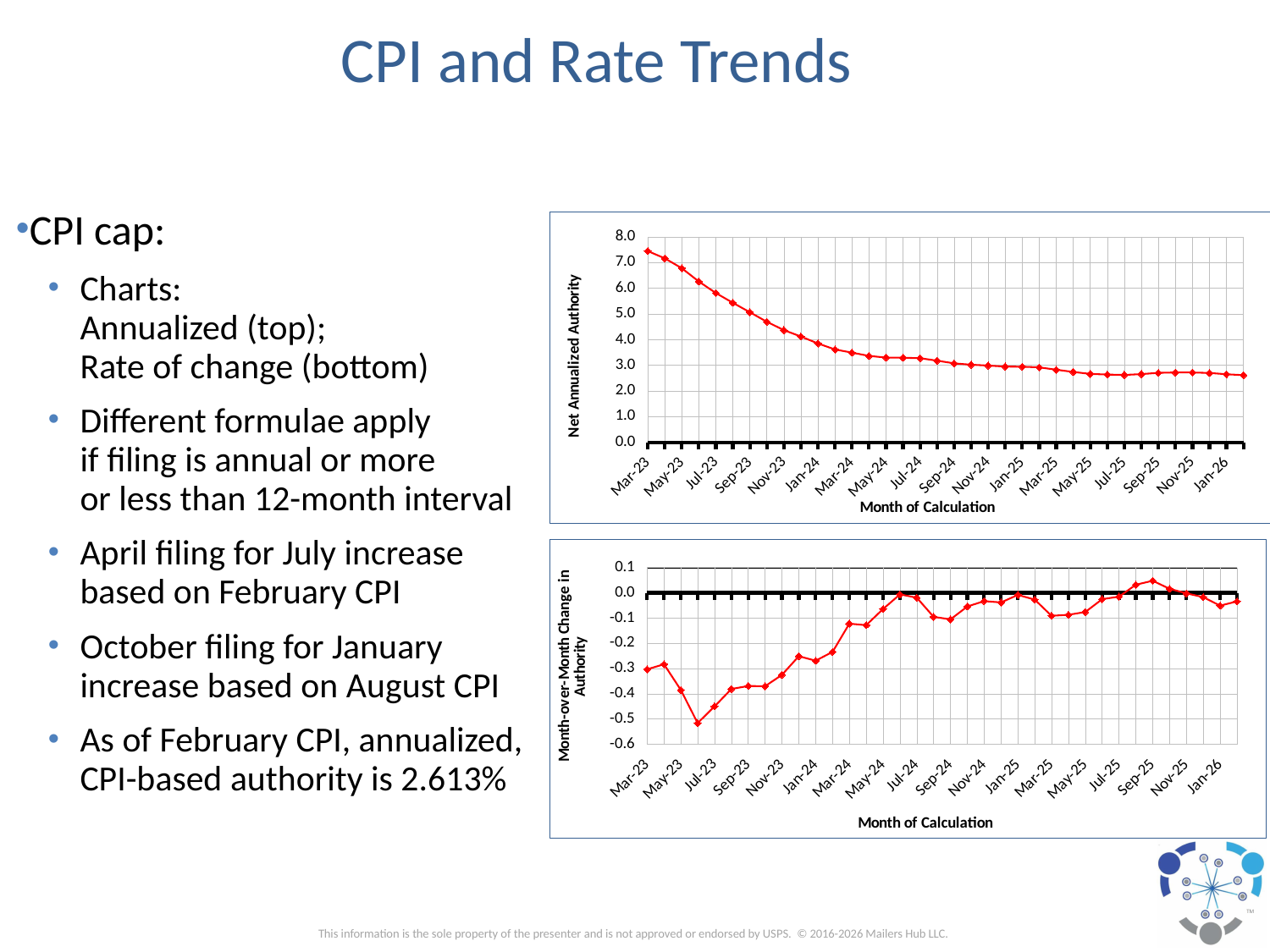
What is the y-axis title of the top chart? Net Annualized Authority What kind of chart is the bottom chart on the slide? line chart In the bottom chart, which month has the lowest Month-over-Month Change in Authority? Jun-23 What kind of chart is the top chart on the slide? line chart In the top chart, is the value for Jan-26 greater or less than 3.0? less In the top chart, which is larger, the value for Mar-23 or the value for Jan-26? Mar-23 What is the x-axis title of the bottom chart? Month of Calculation In the bottom chart, which month has the highest Month-over-Month Change in Authority? Sep-25 In the top chart, do the values generally rise or fall from Mar-23 to Jan-26? fall In the top chart, is the value for Mar-23 greater or less than 7.0? greater In the bottom chart, is the value for Jul-23 greater or less than -0.5? greater In the top chart, which month has the highest Net Annualized Authority? Mar-23